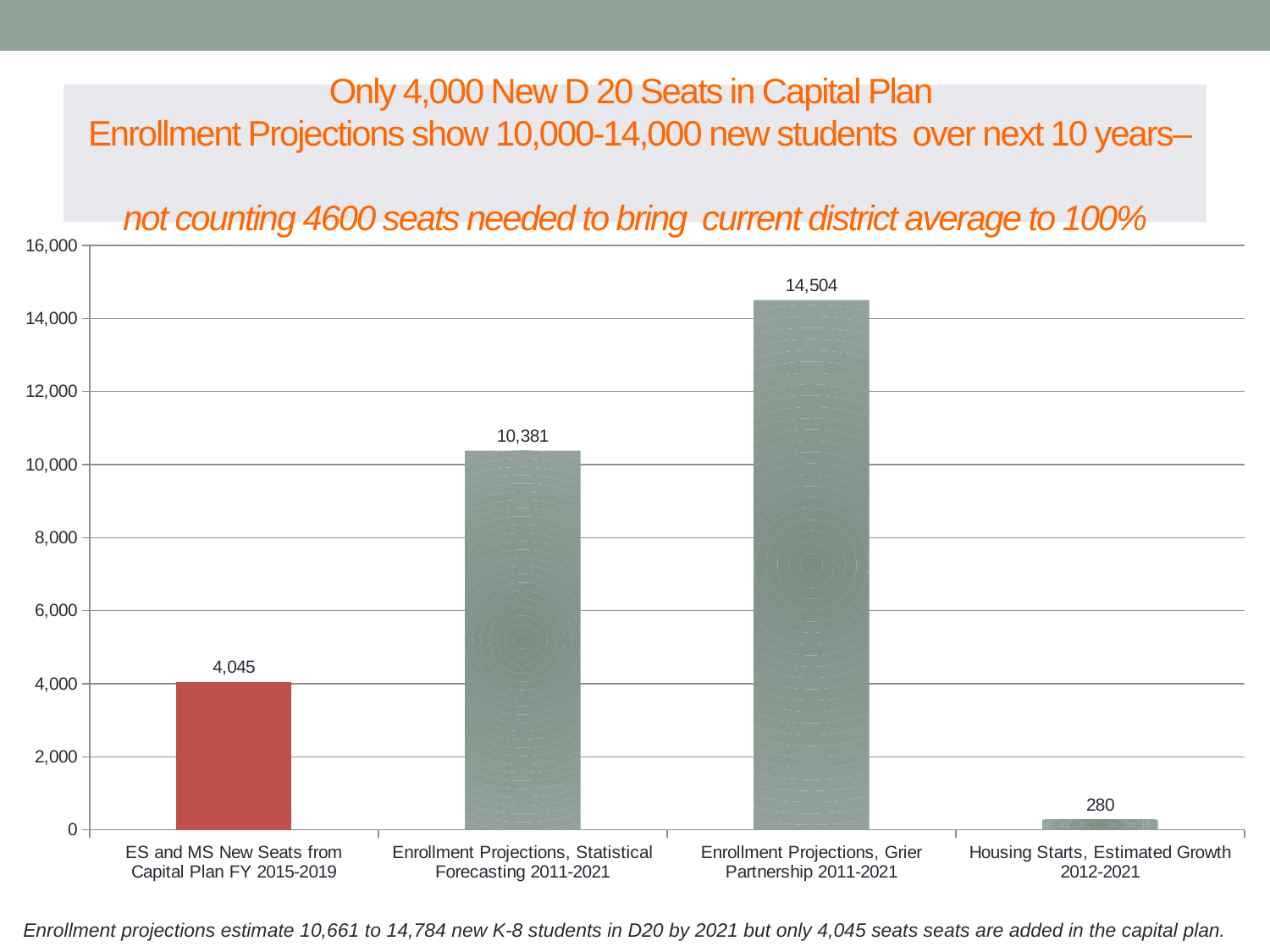
What is the value for Enrollment Projections, Statistical Forecasting 2011-2021? 10,381 Which is larger: the value for ES and MS New Seats from Capital Plan FY 2015-2019 or the value for Housing Starts, Estimated Growth 2012-2021? ES and MS New Seats from Capital Plan FY 2015-2019 How many categories are shown on the x axis? 4 What kind of chart is shown on the slide? bar chart Which category has the lowest value? Housing Starts, Estimated Growth 2012-2021 What is the difference between the Statistical Forecasting projection and the ES and MS New Seats from Capital Plan FY 2015-2019? 6,336 What is the value for Enrollment Projections, Grier Partnership 2011-2021? 14,504 Which category has the highest value? Enrollment Projections, Grier Partnership 2011-2021 What is the difference between the Grier Partnership projection and the Statistical Forecasting projection? 4,123 Is the value for Enrollment Projections, Grier Partnership 2011-2021 greater or less than 14,000? greater What is the value for ES and MS New Seats from Capital Plan FY 2015-2019? 4,045 What is the value for Housing Starts, Estimated Growth 2012-2021? 280